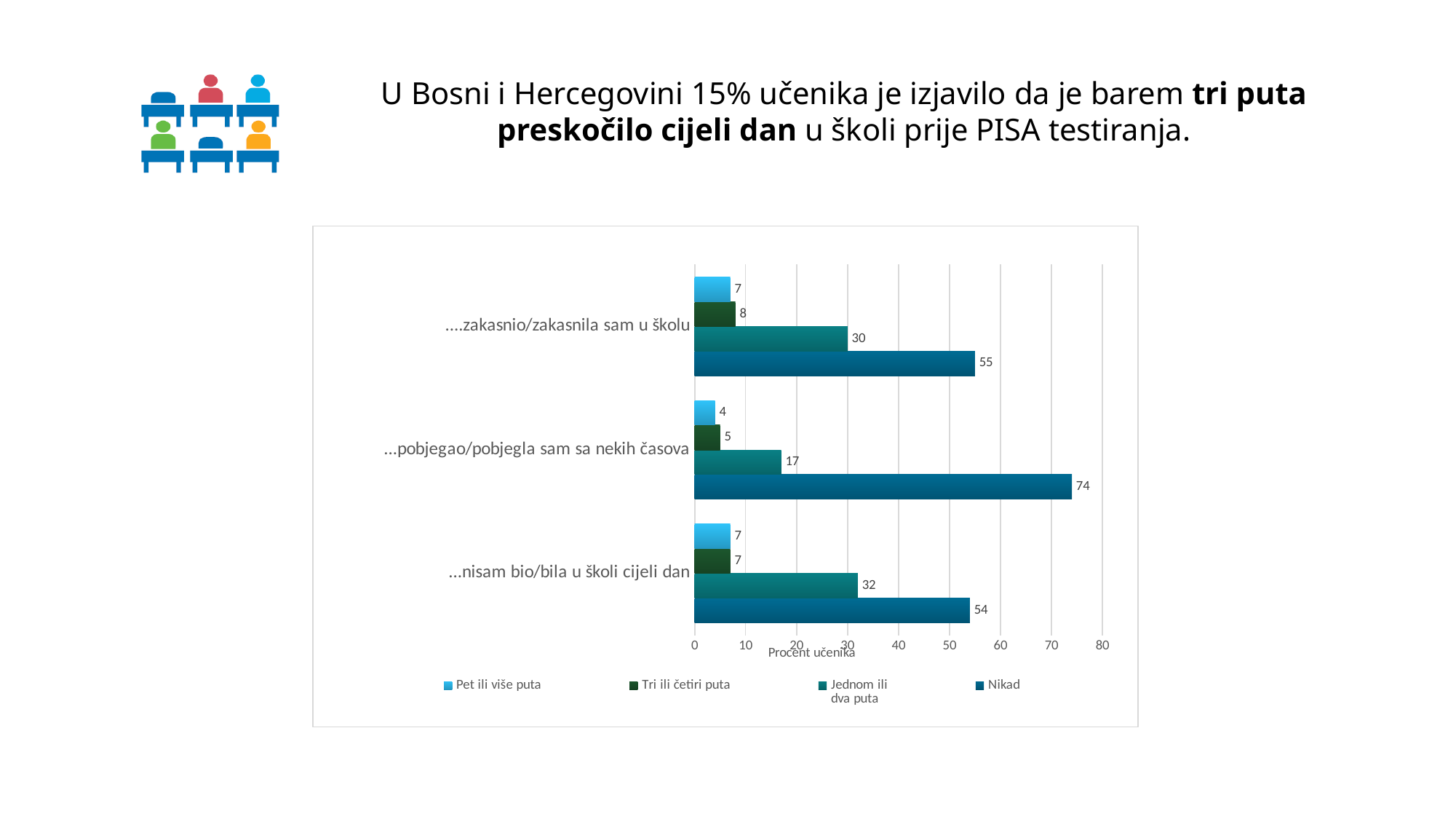
Which is larger: the "Jednom ili dva puta" value for "....zakasnio/zakasnila sam u školu" or for "...nisam bio/bila u školi cijeli dan"? ...nisam bio/bila u školi cijeli dan What is the label of the horizontal axis? Procent učenika What is the value for "Tri ili četiri puta" in the category "....zakasnio/zakasnila sam u školu"? 8 What is the difference between the "Nikad" values for "...pobjegao/pobjegla sam sa nekih časova" and "....zakasnio/zakasnila sam u školu"? 19 What is the value for "Nikad" in the category "...pobjegao/pobjegla sam sa nekih časova"? 74 What is the value for "Pet ili više puta" in the category "...pobjegao/pobjegla sam sa nekih časova"? 4 What kind of chart is shown on the slide? Bar chart How many categories are shown on the chart? 3 How many series does the legend list? 4 Which category has the highest value for the "Nikad" series? ...pobjegao/pobjegla sam sa nekih časova What is the value for "Jednom ili dva puta" in the category "...nisam bio/bila u školi cijeli dan"? 32 Which category has the lowest value for the "Jednom ili dva puta" series? ...pobjegao/pobjegla sam sa nekih časova